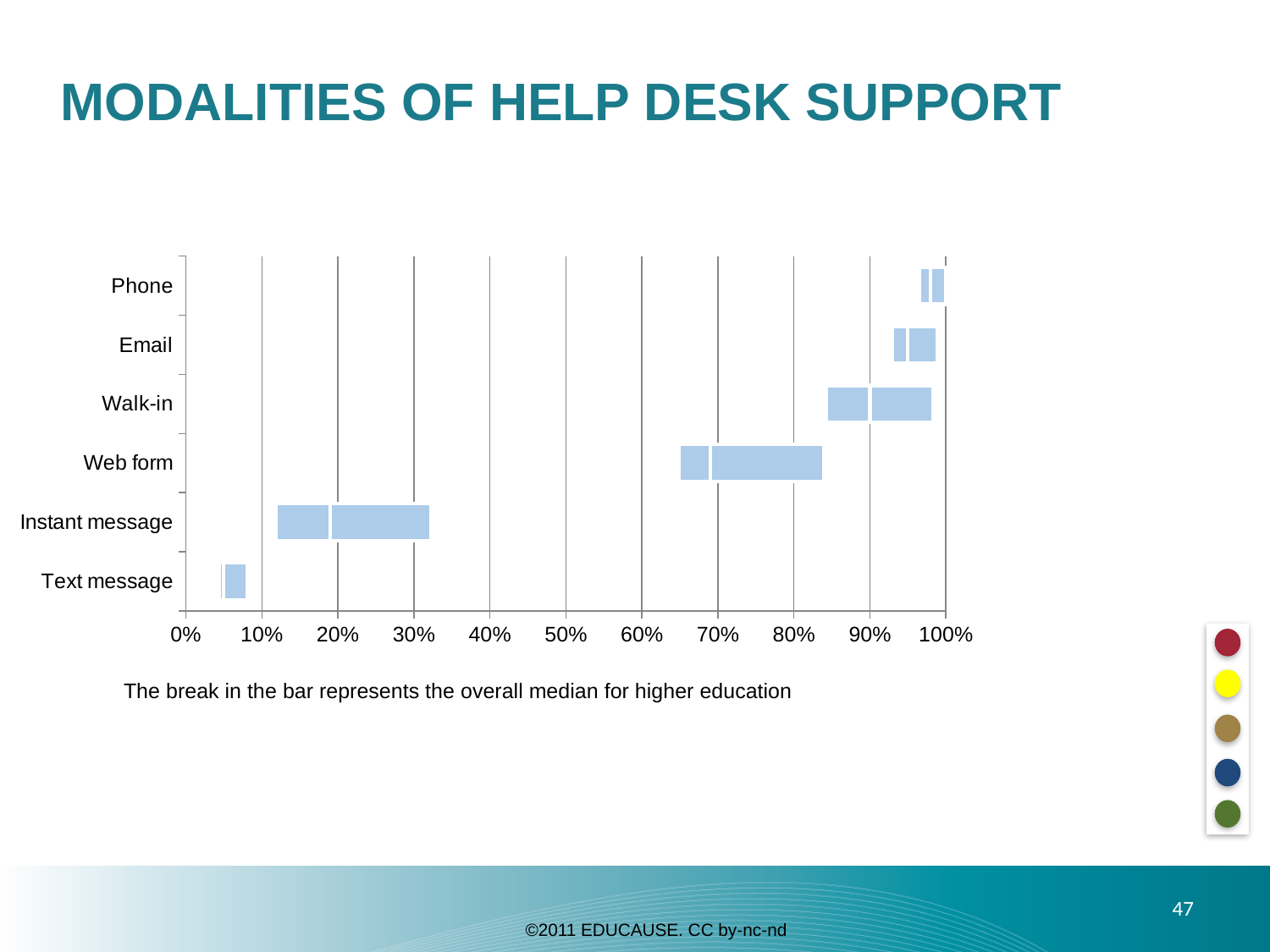
Which has higher values, Web form or Instant message? Web form What kind of chart is shown on the slide? Bar chart How many help desk modalities are listed on the chart? 6 What is the title of the chart on the slide? MODALITIES OF HELP DESK SUPPORT Which modality has the highest values on the chart? Phone Is the value for Text message greater or less than 10%? less Which modality has the lowest values on the chart? Text message Is the value for Walk-in greater or less than 80%? greater Which has higher values, Walk-in or Web form? Walk-in According to the note below the chart, what does the break in each bar represent? The overall median for higher education Is the value for Web form greater or less than 50%? greater